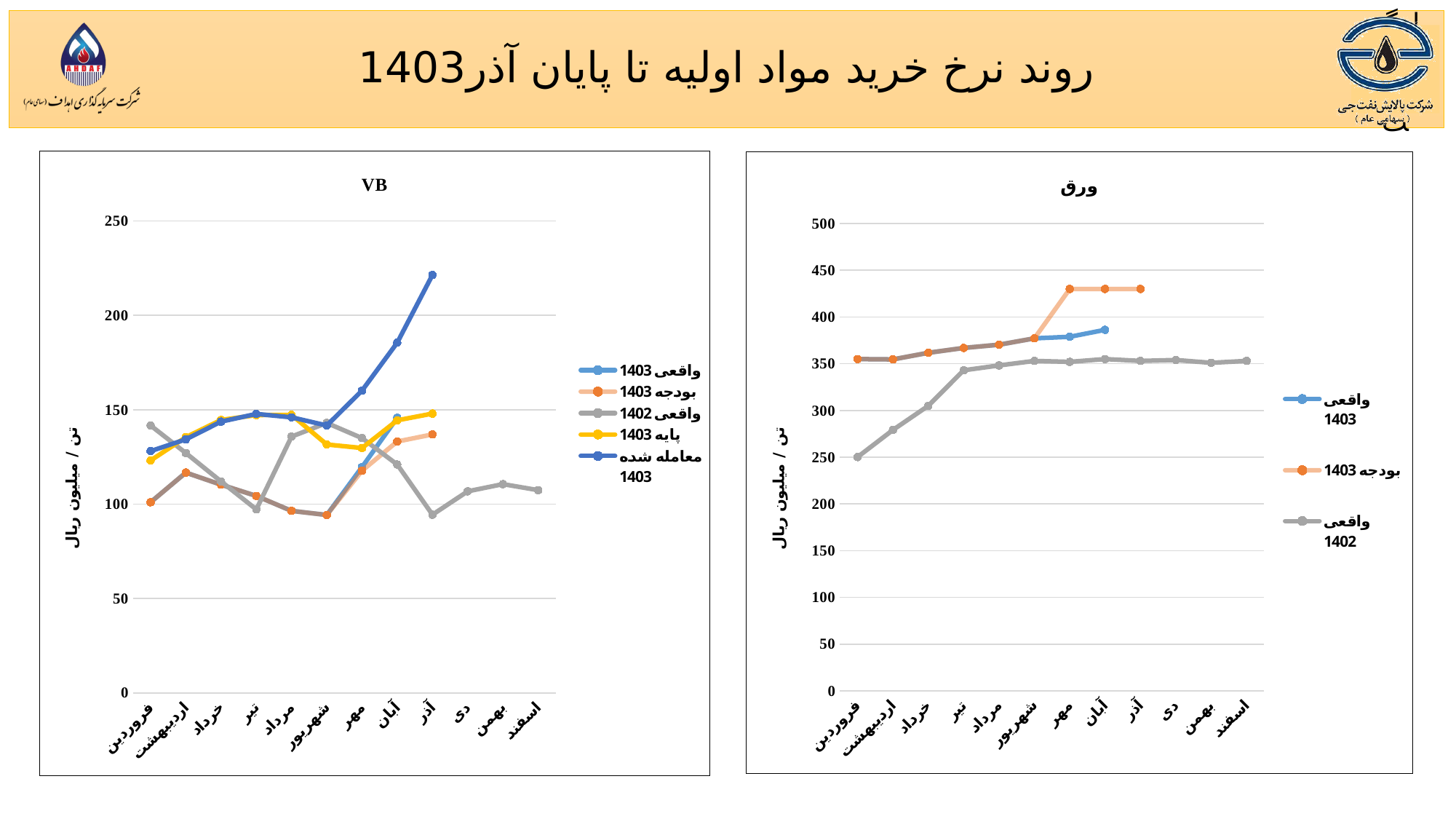
What kind of chart is the VB chart on the left? line chart What is the title of the chart on the right? ورق In the VB chart, which series has the highest value in آذر? معامله شده 1403 In the VB chart, is the value of معامله شده 1403 in آذر greater or less than 200? greater In the ورق chart, does the واقعی 1402 line rise or fall from فروردین to تیر? rise In the VB chart, is the value of واقعی 1402 in آذر greater or less than 100? less How many months are shown on the x axis of the ورق chart? 12 In the ورق chart, is the value of بودجه 1403 in آذر greater or less than 400? greater In the VB chart, which series has the lowest value in آذر? واقعی 1402 How many series does the legend of the ورق chart list? 3 How many series does the legend of the VB chart list? 5